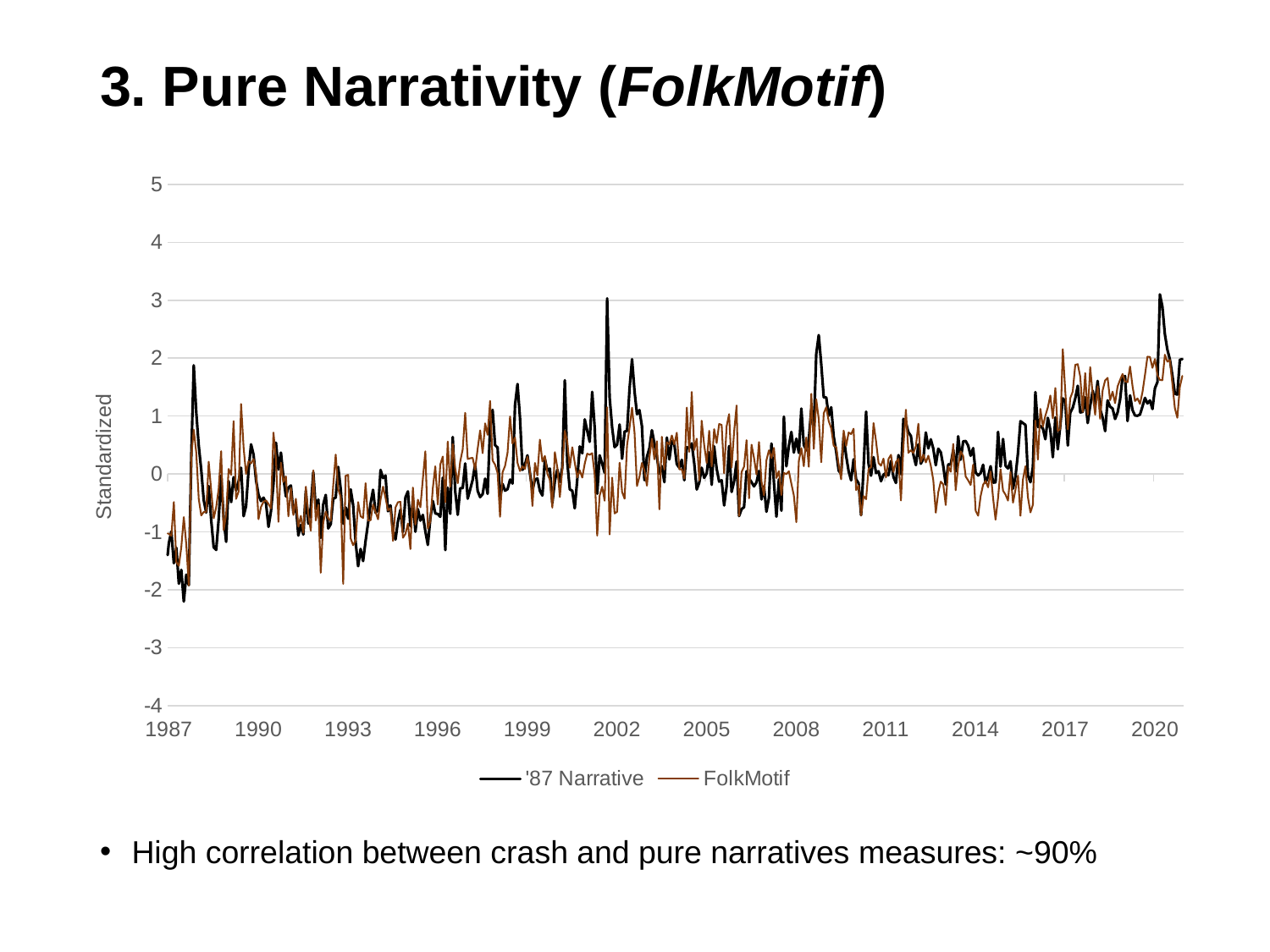
Is the value of the FolkMotif series at its peak around 2017 greater or less than 1? greater Which series reaches the higher peak around 2008, '87 Narrative or FolkMotif? '87 Narrative Do the values of the FolkMotif series generally rise or fall between 2014 and 2020? rise What are the two series named in the legend? '87 Narrative and FolkMotif What is the label on the vertical axis? Standardized How many series does the legend list? 2 What kind of chart is shown on the slide? line chart Which series reaches the higher peak around 2001, '87 Narrative or FolkMotif? '87 Narrative Is the peak of the '87 Narrative series around 2020 greater or less than 2? greater Is the highest value of the '87 Narrative series around 2001 greater or less than 2? greater Do the values of the '87 Narrative series generally rise or fall from 1987 to 2020? rise